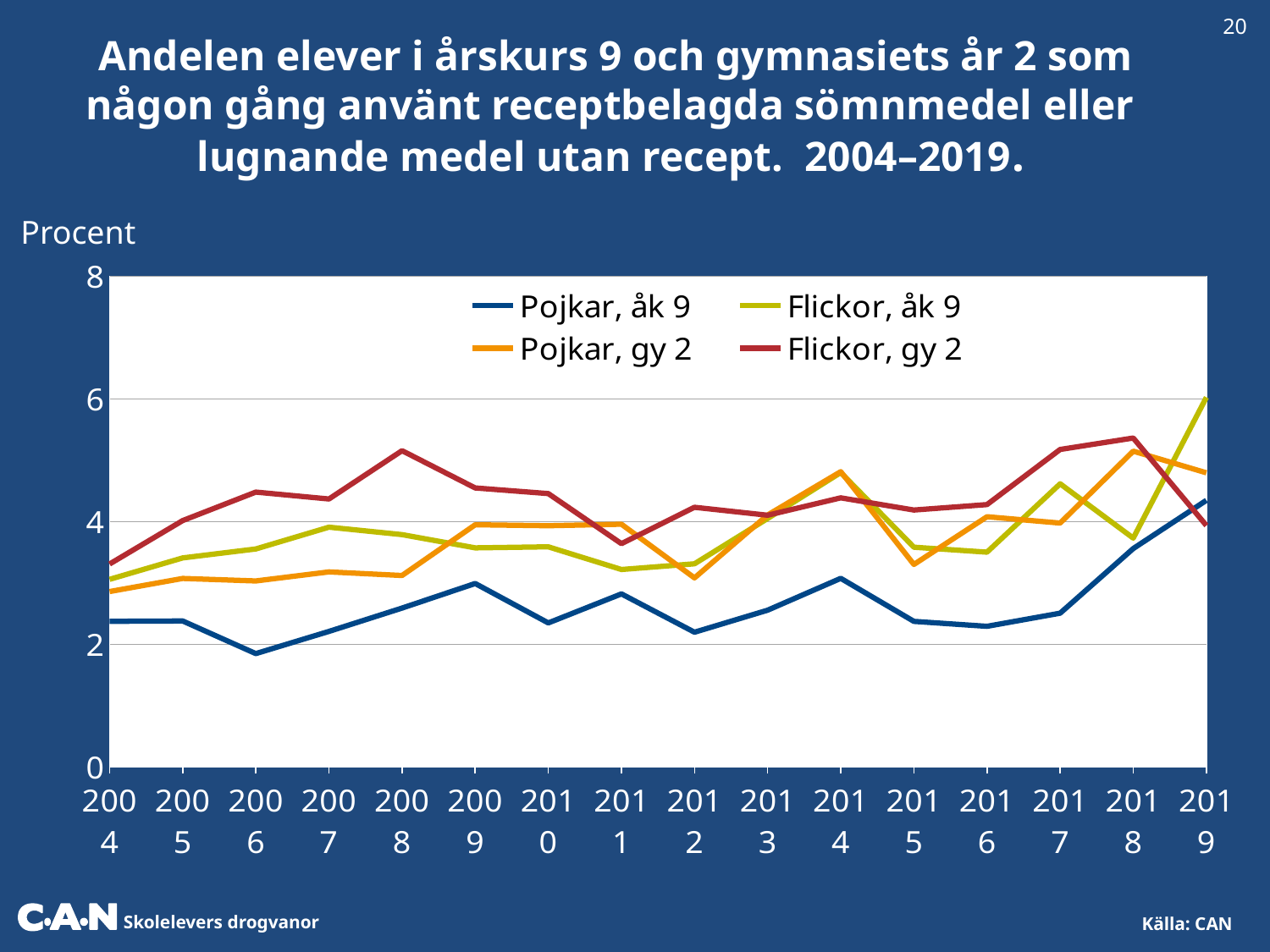
How many series does the legend list? 4 Which series has the highest value in 2008? Flickor, gy 2 Is the value for Pojkar, åk 9 in 2015 greater or less than 4? less Is the value for Flickor, gy 2 in 2008 greater or less than 4? greater How many years are plotted along the x axis? 16 What kind of chart is shown on the slide? Line chart Which series are listed in the legend? Pojkar, åk 9; Pojkar, gy 2; Flickor, åk 9; Flickor, gy 2 Which series has the lowest value in 2004? Pojkar, åk 9 Is the value for Flickor, gy 2 in 2018 greater or less than 4? greater What is the label shown above the y axis? Procent In 2019, which is larger: Flickor, åk 9 or Pojkar, åk 9? Flickor, åk 9